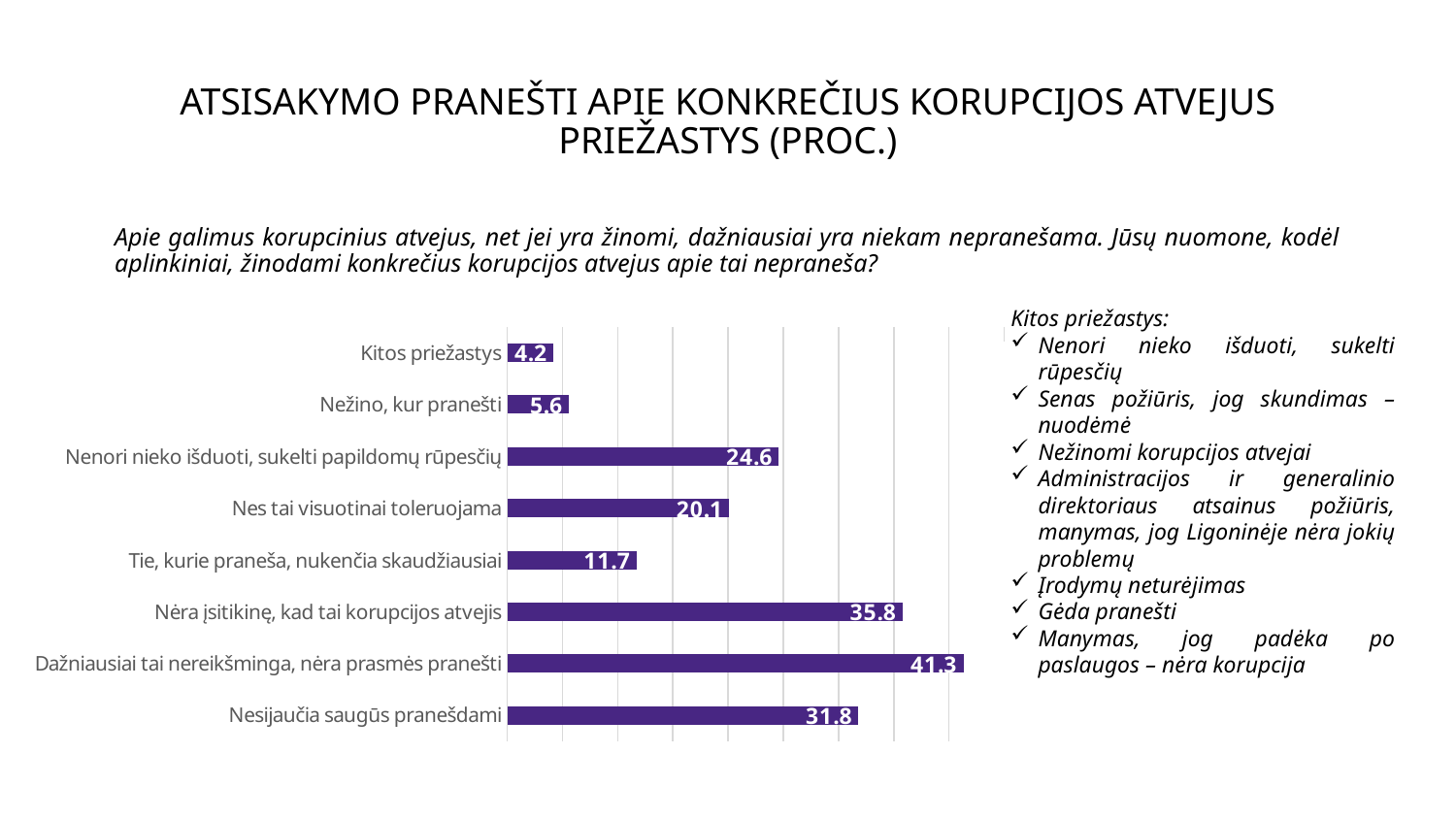
Which is larger: the value for "Nesijaučia saugūs pranešdami" or the value for "Nenori nieko išduoti, sukelti papildomų rūpesčių"? Nesijaučia saugūs pranešdami What is the value for "Nežino, kur pranešti"? 5.6 How many categories are shown in the chart? 8 What is the value for "Nesijaučia saugūs pranešdami"? 31.8 Which category has the lowest value? Kitos priežastys What is the difference between the values for "Nenori nieko išduoti, sukelti papildomų rūpesčių" and "Nes tai visuotinai toleruojama"? 4.5 What is the value for "Dažniausiai tai nereikšminga, nėra prasmės pranešti"? 41.3 What kind of chart is shown on the slide? Bar chart What colour are the bars in the chart? Purple What is the difference between the values for "Dažniausiai tai nereikšminga, nėra prasmės pranešti" and "Nėra įsitikinę, kad tai korupcijos atvejis"? 5.5 Which category has the highest value? Dažniausiai tai nereikšminga, nėra prasmės pranešti What is the value for "Tie, kurie praneša, nukenčia skaudžiausiai"? 11.7